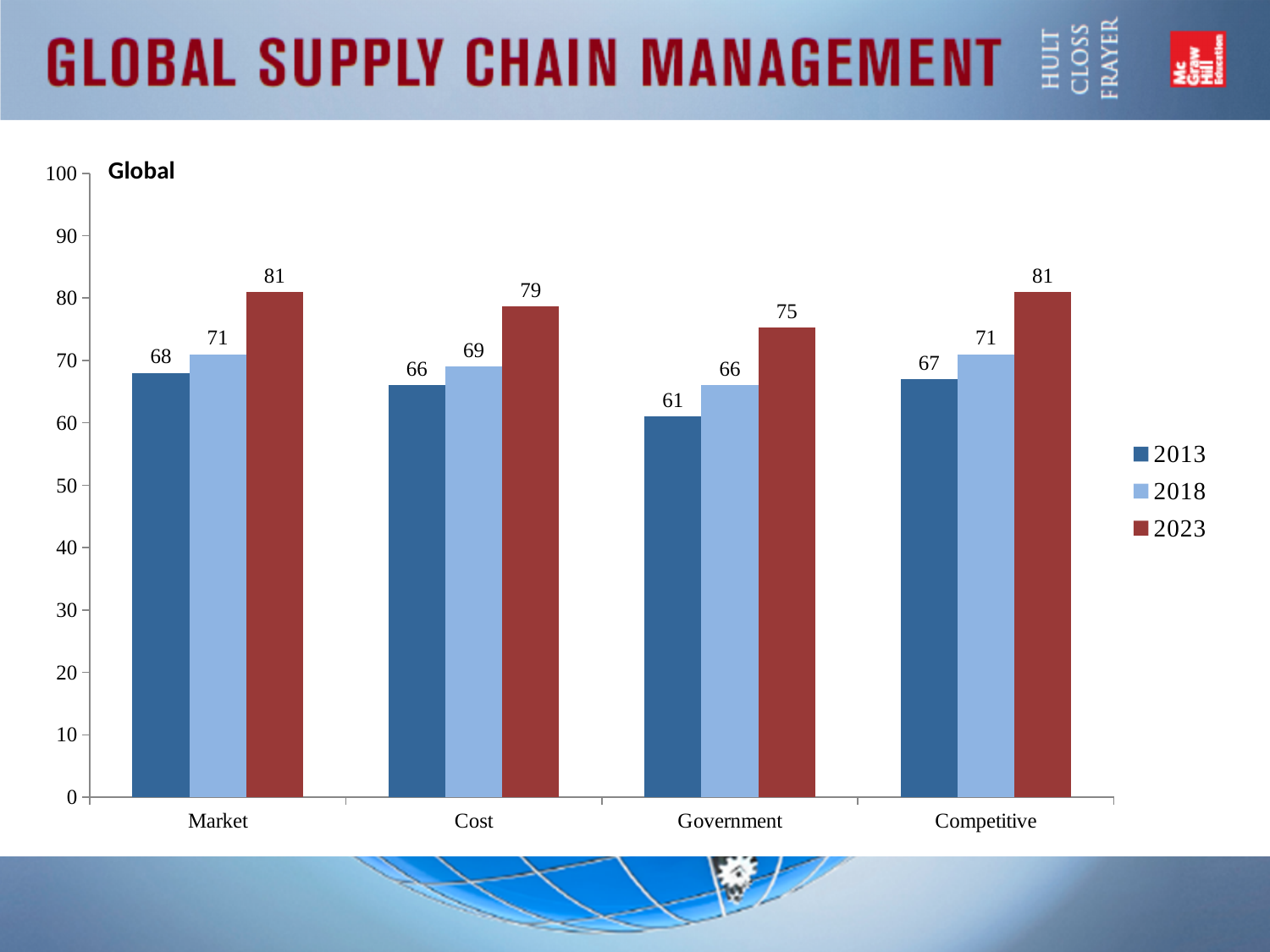
What is the value for Cost in 2018? 69 What is the difference between the 2023 values for Market and Cost? 2 Which category has the lowest value in 2013? Government What kind of chart is shown on the slide? Bar chart What is the value for Government in 2023? 75 Which is larger, the 2018 value for Market or the 2018 value for Cost? Market What is the title of the chart? Global What is the value for Market in 2013? 68 How many categories are shown on the x axis? 4 What is the difference between the 2023 and 2013 values for Government? 14 How many series does the legend list? 3 Which category has the lowest value in 2023? Government